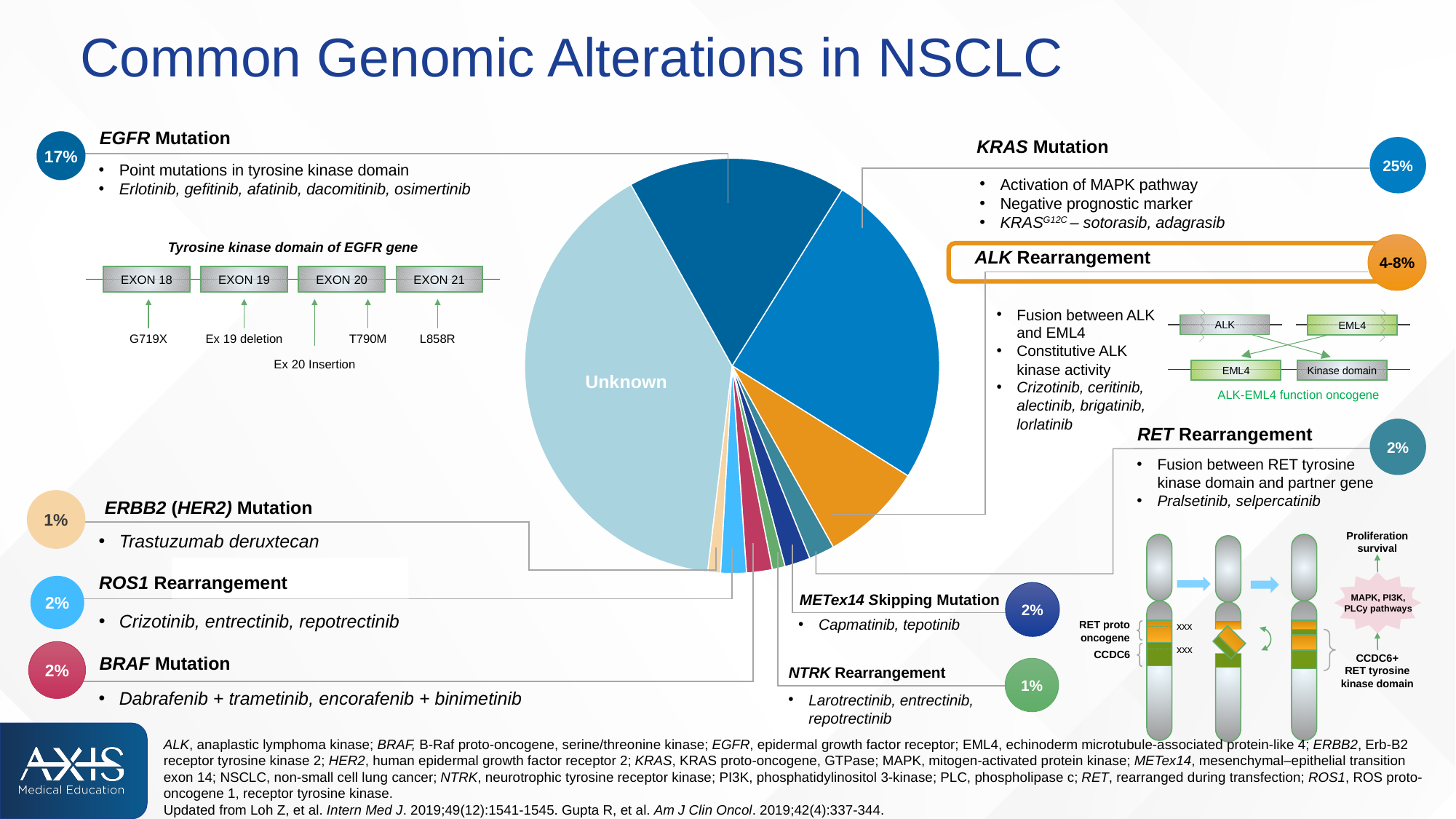
Which slice of the pie chart is the largest? Unknown Which has a higher percentage, KRAS mutation or EGFR mutation? KRAS mutation What percentage is shown for RET rearrangement? 2% What percentage is shown for KRAS mutation? 25% Which slice has its label printed directly inside the pie chart? Unknown What percentage is shown for NTRK rearrangement? 1% What is the title of the slide containing the pie chart? Common Genomic Alterations in NSCLC What kind of chart is shown on the slide? pie chart What percentage range is shown for ALK rearrangement? 4-8% What is the difference in percentage points between KRAS mutation (25%) and EGFR mutation (17%)? 8 What percentage is shown for EGFR mutation? 17% What percentage is shown for ERBB2 (HER2) mutation? 1%